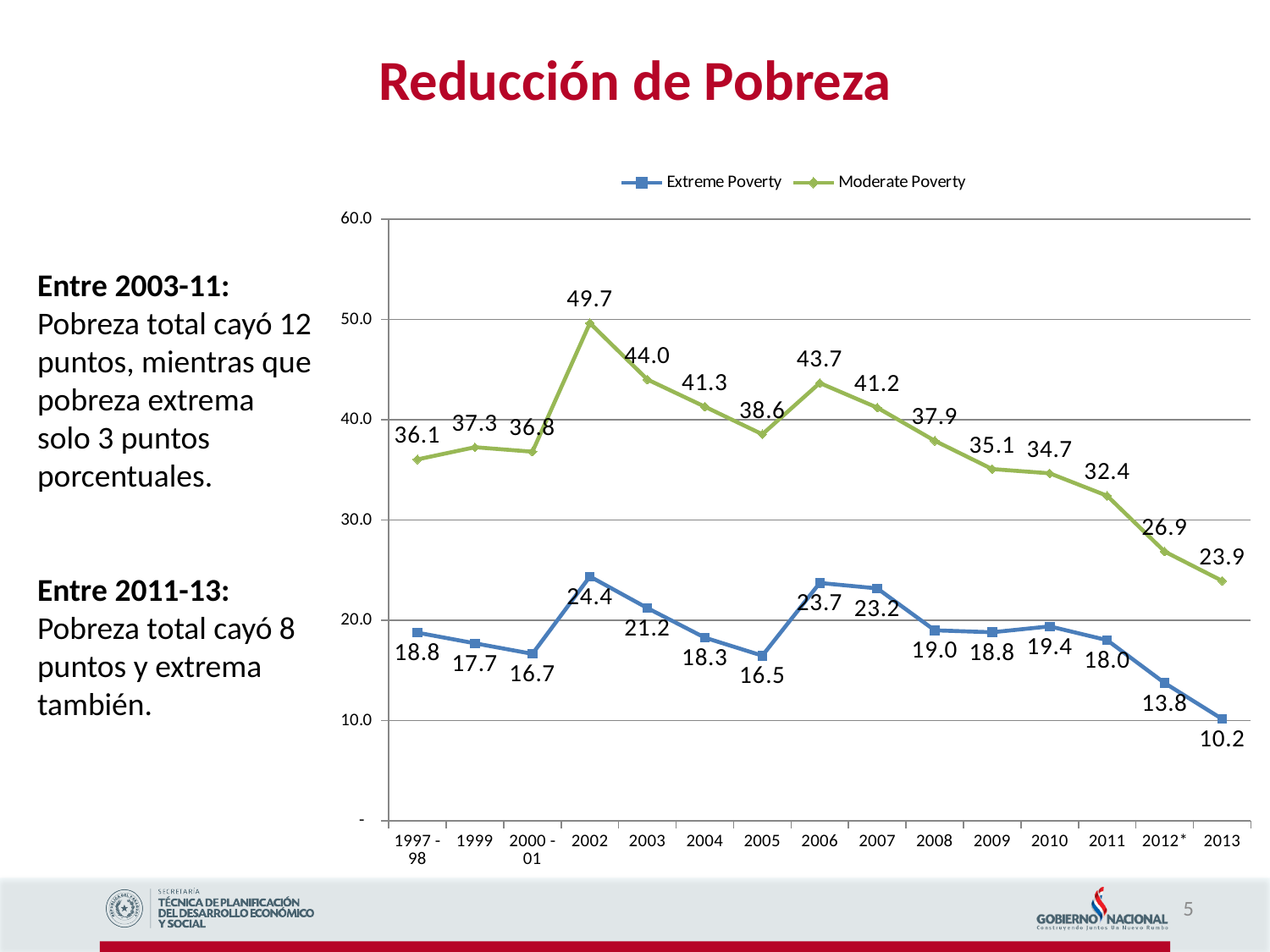
Which is larger, the Extreme Poverty value for 2002 or for 2007? 2002 Does Moderate Poverty rise or fall from 2006 to 2013? fall How many series does the legend list? 2 How many time points are plotted on the x axis? 15 What type of chart is shown on the slide? line chart In which year is Extreme Poverty lowest? 2013 What is the Extreme Poverty value for 2013? 10.2 What is the Extreme Poverty value for 2006? 23.7 What is the title of the slide containing the chart? Reducción de Pobreza What is the difference between Moderate Poverty and Extreme Poverty in 2013? 13.7 In which year is Moderate Poverty highest? 2002 What is the Moderate Poverty value for 2002? 49.7